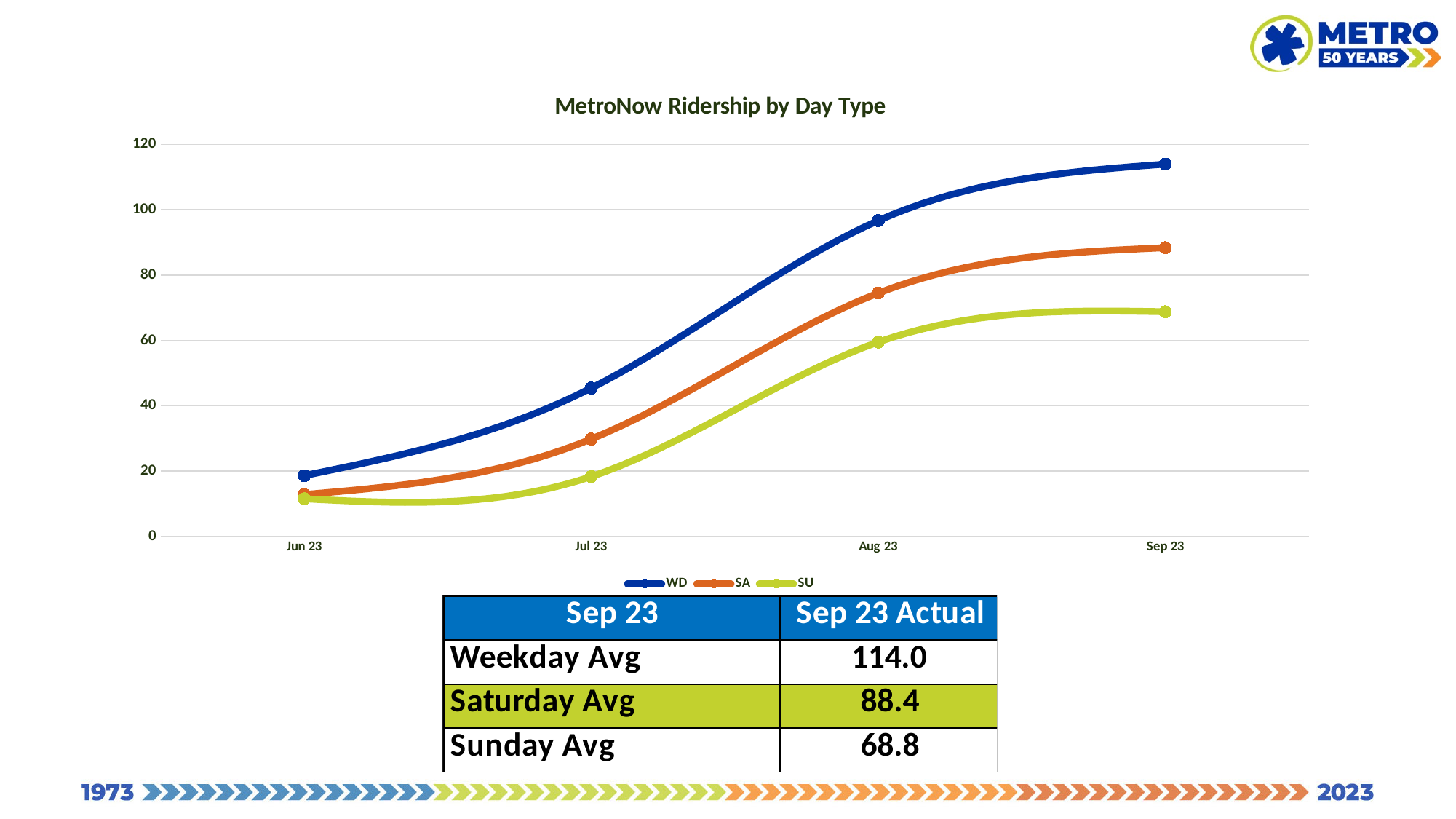
What is the difference between the Weekday Avg and Sunday Avg values for Sep 23? 45.2 Does the SU series rise or fall from Jun 23 to Sep 23? rise What is the difference between the Weekday Avg and Saturday Avg values for Sep 23? 25.6 Which series has the highest value in Sep 23? WD How many series does the chart legend list? 3 What is the Sep 23 value for the SA (Saturday Avg) series? 88.4 What is the Sep 23 value for the SU (Sunday Avg) series? 68.8 How many months are shown on the x axis of the chart? 4 What is the Sep 23 value for the WD (Weekday Avg) series? 114.0 Is the WD value for Jul 23 greater or less than 40? greater What type of chart is shown on the slide? line chart What is the title of the chart? MetroNow Ridership by Day Type